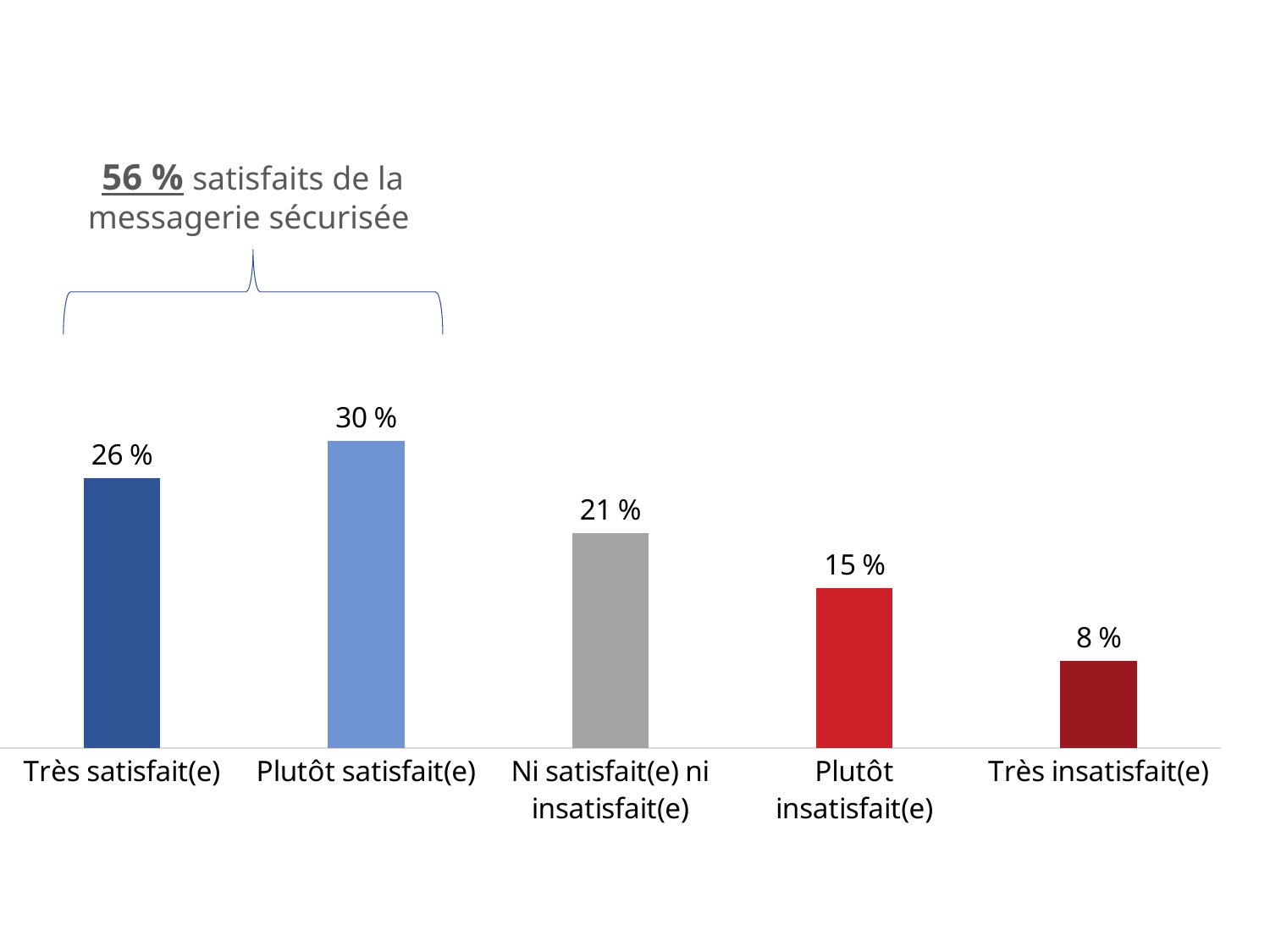
Which category has the highest value? Plutôt satisfait(e) What is the value for Plutôt satisfait(e)? 30 % What is the value for Plutôt insatisfait(e)? 15 % How many categories are shown in the chart? 5 What is the value for Très insatisfait(e)? 8 % What is the value for Ni satisfait(e) ni insatisfait(e)? 21 % Which category has the lowest value? Très insatisfait(e) Which is larger, Ni satisfait(e) ni insatisfait(e) or Plutôt insatisfait(e)? Ni satisfait(e) ni insatisfait(e) What kind of chart is this? Bar chart What is the value for Très satisfait(e)? 26 % What is the difference between Plutôt satisfait(e) and Très satisfait(e)? 4 % According to the annotation above the chart, what percentage are satisfied with the secure messaging (messagerie sécurisée)? 56 %